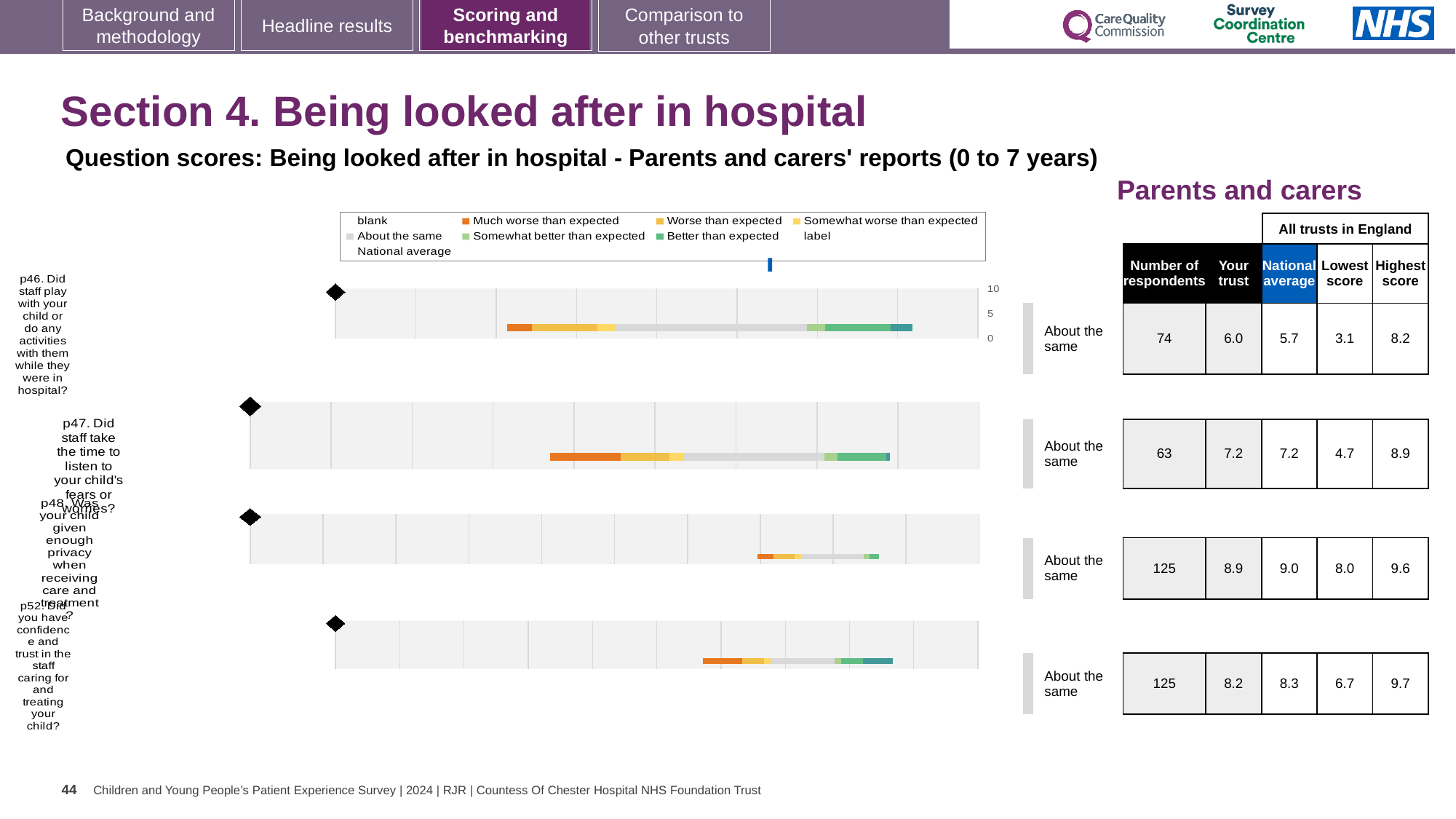
How many respondents answered p48 (Was your child given enough privacy when receiving care and treatment?)? 125 Which question has the highest 'Your trust' score? p48 How many survey questions (p46, p47, p48, p52) are plotted on the slide? 4 What benchmark category is shown next to the chart for p47? About the same What is the national average score for p47 (Did staff take the time to listen to your child's fears or worries?)? 7.2 For p48, what is the difference between the highest score (9.6) and the lowest score (8.0) across all trusts in England? 1.6 What is the 'Your trust' score for p46 (Did staff play with your child or do any activities with them while they were in hospital?)? 6.0 What is the lowest score across all trusts in England for p46? 3.1 What kind of chart is used to show the question scores on this slide? bar chart What is the highest score across all trusts in England for p52 (Did you have confidence and trust in the staff caring for and treating your child?)? 9.7 Which question has the lowest 'Your trust' score? p46 For p52, which is larger: the 'Your trust' score or the national average? National average